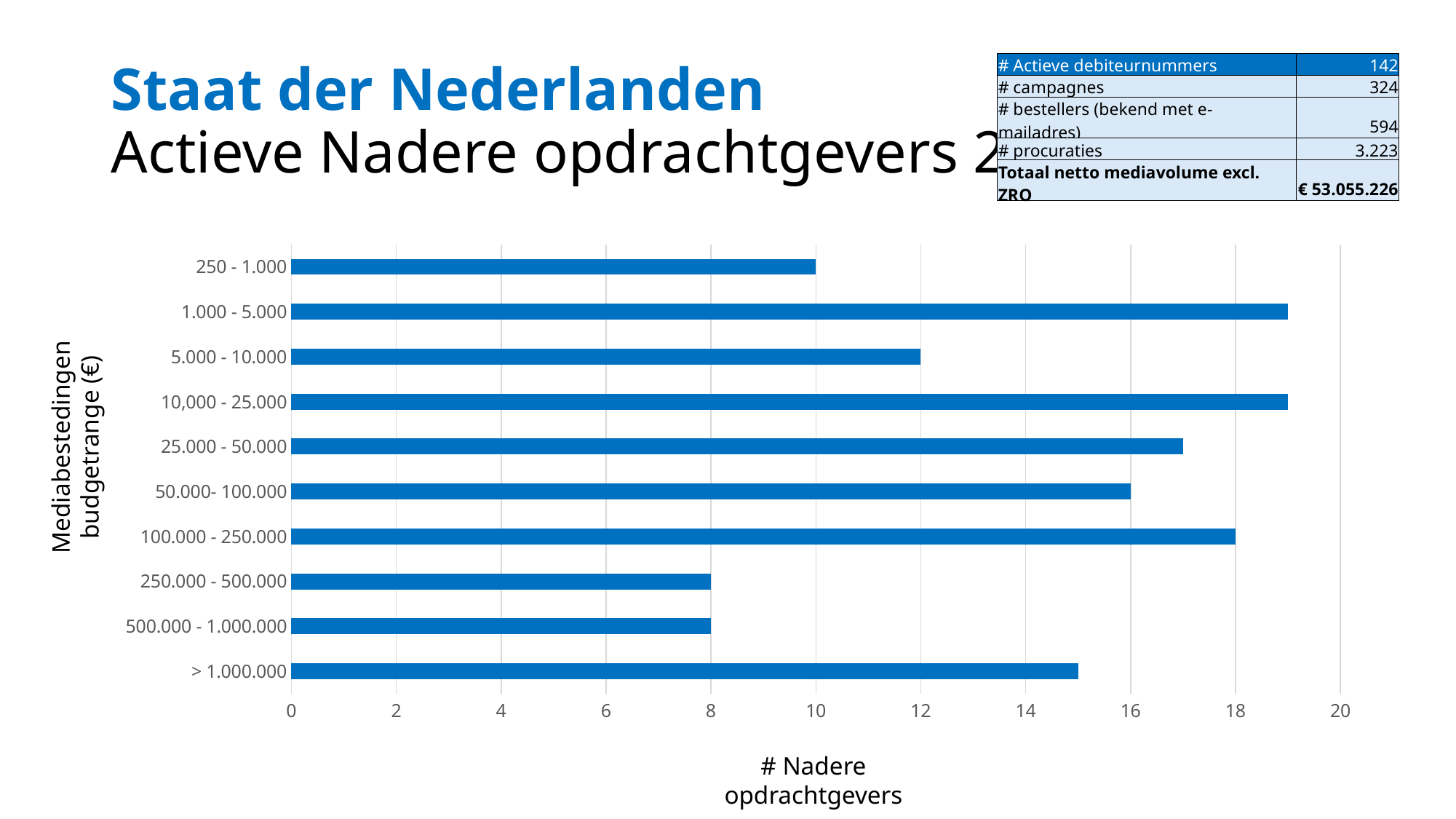
How many budget range categories are plotted on the chart? 10 Which has a larger value: 25.000 - 50.000 or 500.000 - 1.000.000? 25.000 - 50.000 What is the number of Nadere opdrachtgevers for the 50.000- 100.000 budget range? 16 Is the value for the > 1.000.000 budget range greater or less than 14? greater What is the number of Nadere opdrachtgevers for the 5.000 - 10.000 budget range? 12 What kind of chart is shown on the slide? bar chart What is the number of Nadere opdrachtgevers for the 100.000 - 250.000 budget range? 18 What is the title of the horizontal axis of the chart? # Nadere opdrachtgevers What is the number of Nadere opdrachtgevers for the 250 - 1.000 budget range? 10 Is the value for the 1.000 - 5.000 budget range greater or less than 18? greater What is the number of Nadere opdrachtgevers for the 250.000 - 500.000 budget range? 8 What is the difference between the values for 100.000 - 250.000 and 250.000 - 500.000? 10